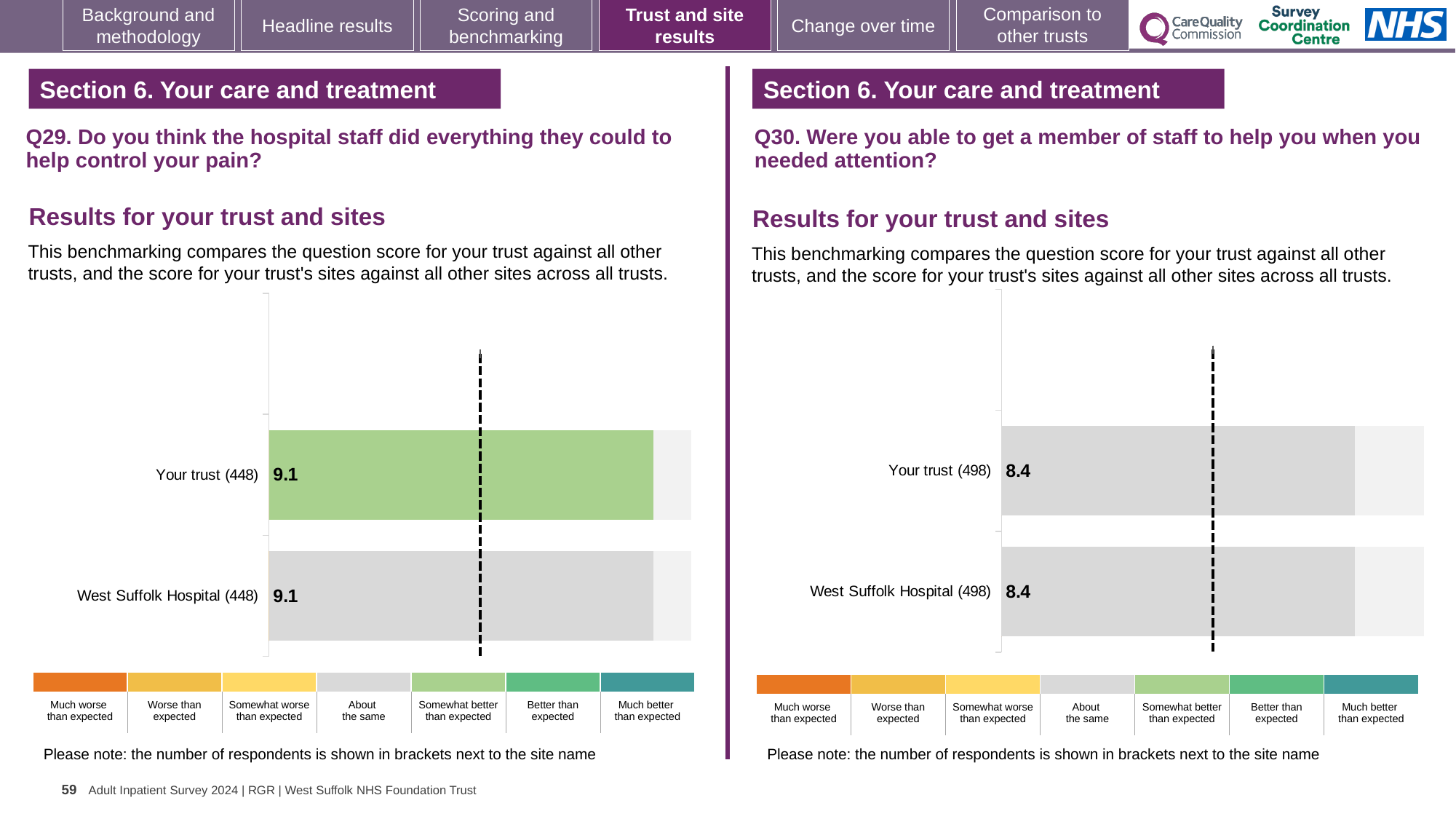
In the Q29 chart on the left, which benchmark category does the colour of the Your trust bar correspond to? Somewhat better than expected In the Q30 chart on the right, which benchmark category does the colour of the Your trust bar correspond to? About the same In the Q29 chart on the left, what is the score for Your trust (448)? 9.1 In the Q30 chart on the right, what is the score for West Suffolk Hospital (498)? 8.4 How many bars are plotted in the Q30 chart on the right? 2 In the Q29 chart on the left, what is the difference between the score for Your trust and the score for West Suffolk Hospital? 0 How many bars are plotted in the Q29 chart on the left? 2 In the Q30 chart on the right, what is the difference between the score for Your trust and the score for West Suffolk Hospital? 0 How many respondents are shown in brackets for Your trust in the Q30 chart on the right? 498 In the Q29 chart on the left, what is the score for West Suffolk Hospital (448)? 9.1 What kind of chart is used in the Q29 chart on the left? Bar chart In the Q30 chart on the right, what is the score for Your trust (498)? 8.4